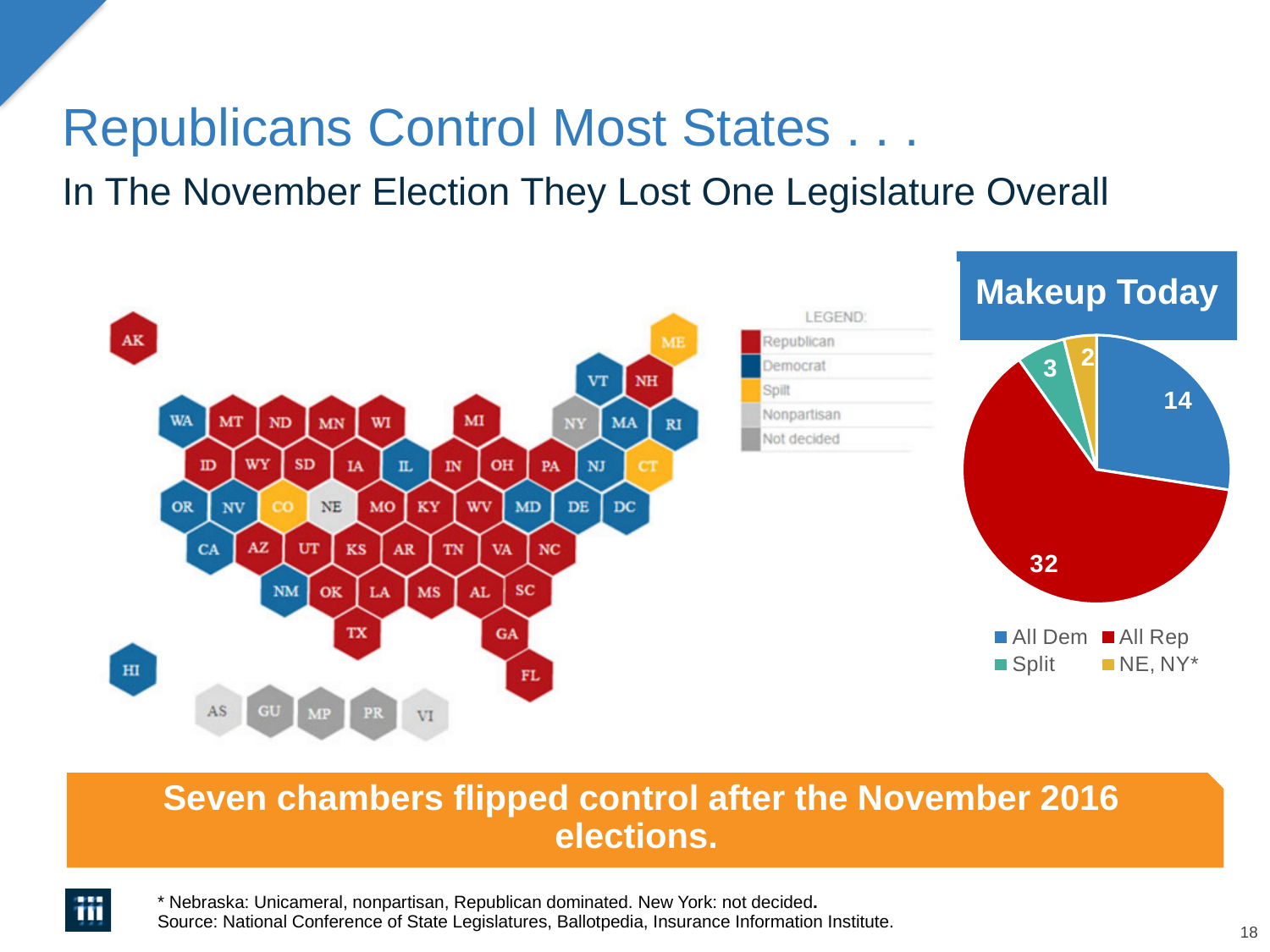
How many slices does the Makeup Today pie chart have? 4 In the Makeup Today pie chart, which category has the smallest slice? NE, NY* In the Makeup Today pie chart, what is the value for All Rep? 32 In the Makeup Today pie chart, what is the value for All Dem? 14 What kind of chart is the Makeup Today chart on the right of the slide? Pie chart In the Makeup Today pie chart, what is the difference between the All Rep and All Dem values? 18 In the Makeup Today pie chart, what is the value for NE, NY*? 2 In the Makeup Today pie chart, what is the value for Split? 3 What is the total of all the values shown in the Makeup Today pie chart? 51 In the Makeup Today pie chart, which is larger, All Dem or Split? All Dem How many entries does the legend of the Makeup Today pie chart list? 4 In the Makeup Today pie chart, which category has the largest slice? All Rep